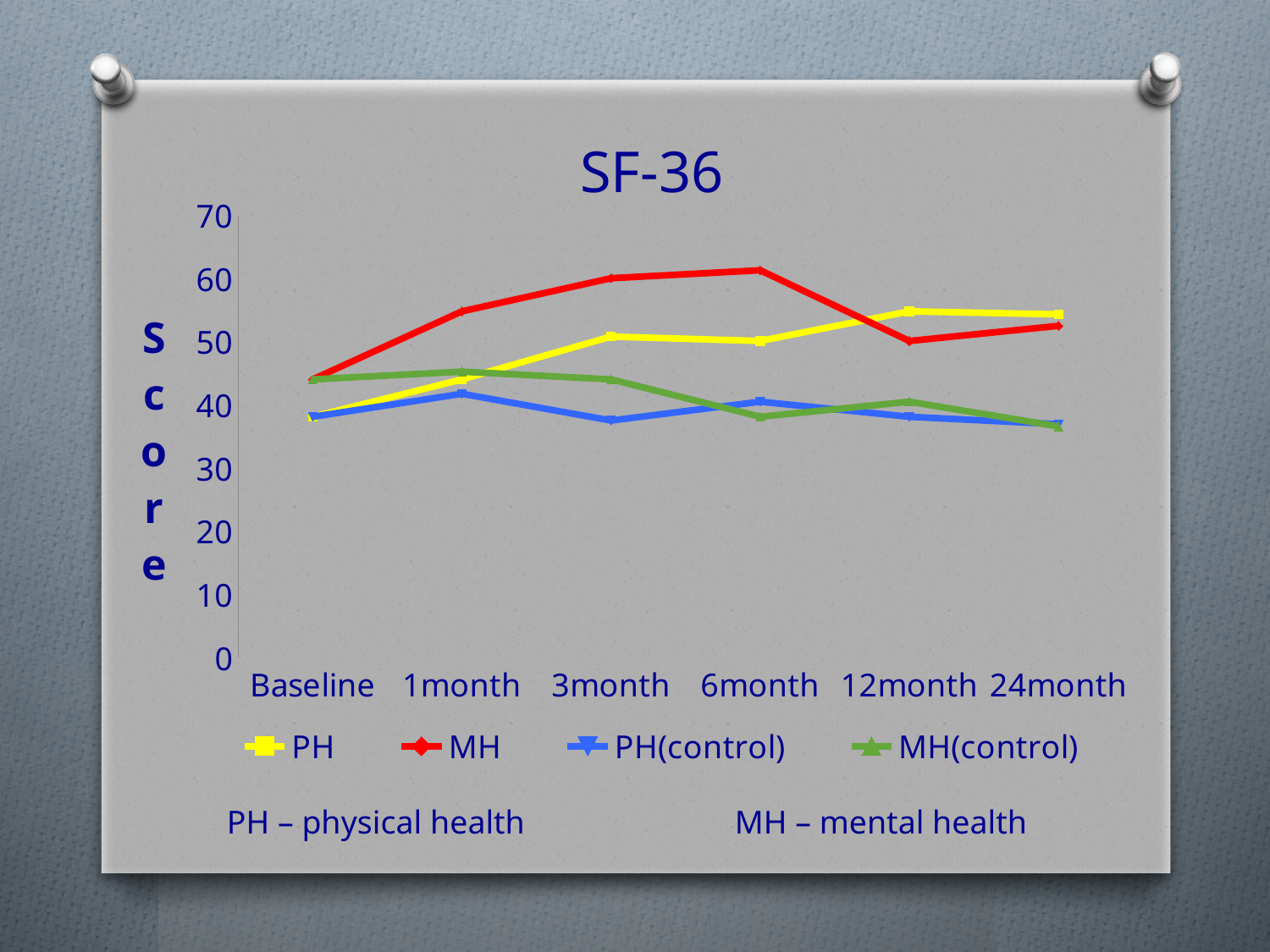
Which series has the highest value at 6month? MH How many series does the legend list? 4 What kind of chart is shown on the slide? line chart What is the title of the chart? SF-36 How many time points are plotted along the x axis? 6 Is the value for MH at 1month greater or less than 50? greater Is the value for PH at 12month greater or less than 50? greater Is the value for MH(control) at 1month greater or less than 40? greater At 12month, which is larger, PH or MH? PH Which series has the lowest value at 3month? PH(control) Does the PH series rise or fall from Baseline to 12month? rise